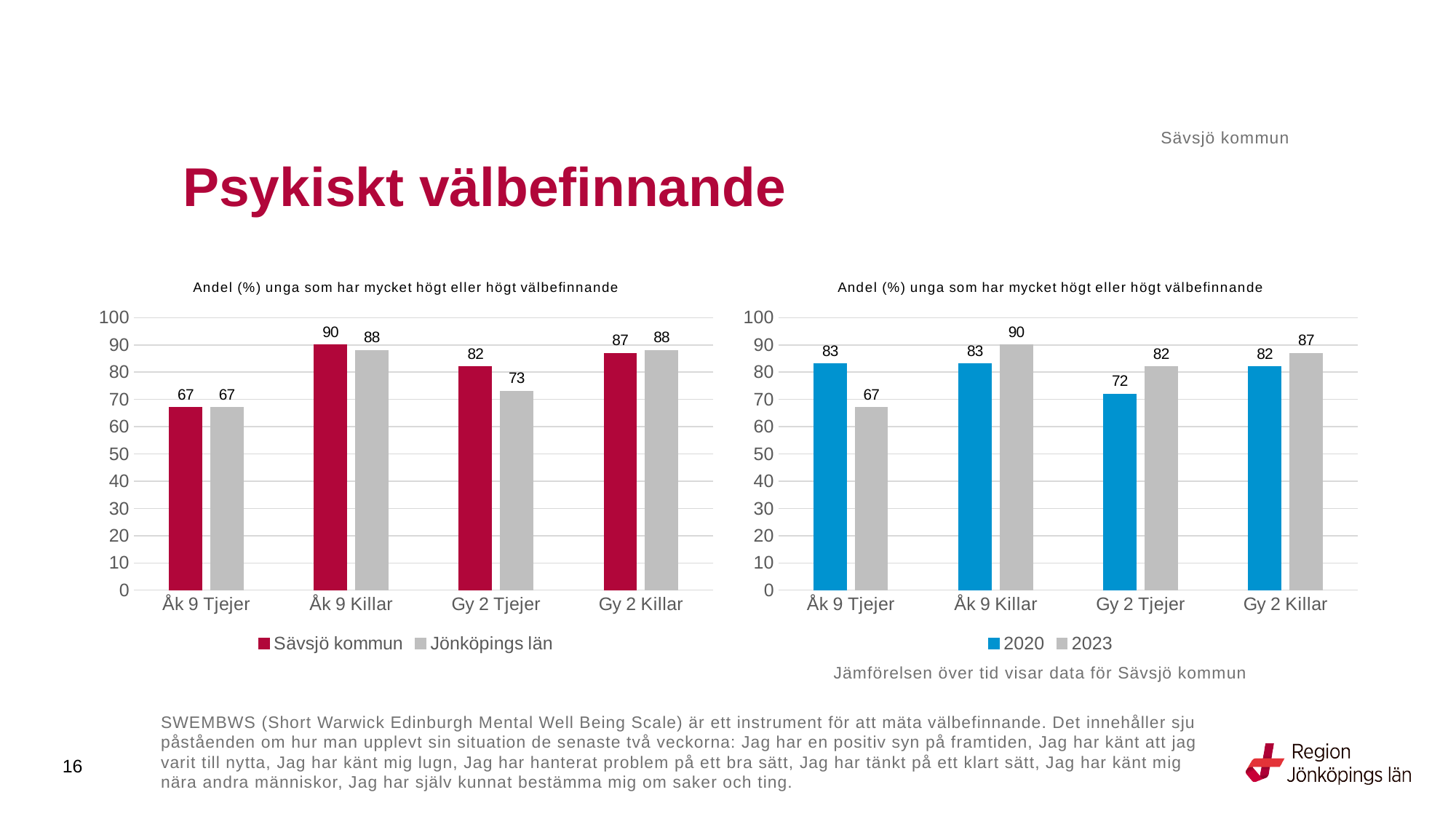
In the right chart, which is larger for Gy 2 Killar, 2020 or 2023? 2023 In the right chart, which category has the lowest value for 2023? Åk 9 Tjejer In the left chart, what is the value for Jönköpings län for Åk 9 Killar? 88 In the left chart, what is the value for Sävsjö kommun for Gy 2 Tjejer? 82 In the right chart, what is the value for 2020 for Gy 2 Tjejer? 72 In the right chart, what is the difference between 2020 and 2023 for Åk 9 Tjejer? 16 How many series does the legend of the right chart list? 2 In the right chart, what is the value for 2023 for Åk 9 Tjejer? 67 How many categories are shown on the x axis of the left chart? 4 In the left chart, which category has the highest value for Sävsjö kommun? Åk 9 Killar In the left chart, what is the difference between Sävsjö kommun and Jönköpings län for Gy 2 Tjejer? 9 What kind of chart is the left chart? Bar chart